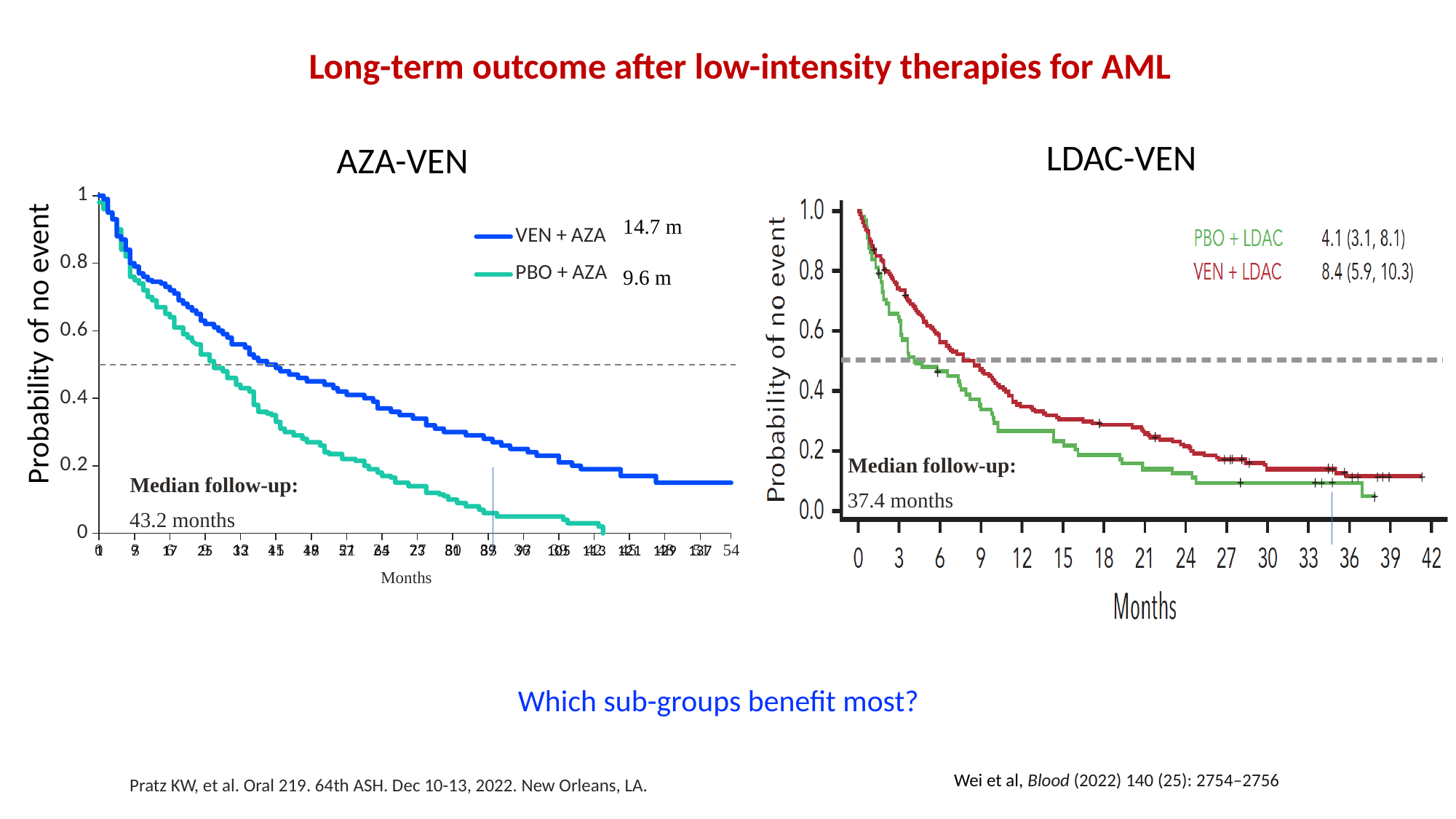
On the AZA-VEN chart, what is the median follow-up? 43.2 months What kind of chart is the LDAC-VEN chart? Line chart On the AZA-VEN chart, what median value is shown for VEN + AZA? 14.7 m On the LDAC-VEN chart, is the VEN + LDAC curve at 12 months greater or less than 0.2? greater On the AZA-VEN chart, which arm has the larger median, VEN + AZA or PBO + AZA? VEN + AZA On the AZA-VEN chart, what is the difference between the VEN + AZA and PBO + AZA medians? 5.1 m On the LDAC-VEN chart, what value is shown for PBO + LDAC? 4.1 (3.1, 8.1) On the LDAC-VEN chart, how many series does the legend list? 2 On the LDAC-VEN chart, what value is shown for VEN + LDAC? 8.4 (5.9, 10.3) On the AZA-VEN chart, what median value is shown for PBO + AZA? 9.6 m On the LDAC-VEN chart, what is the median follow-up? 37.4 months On the AZA-VEN chart, do the curves rise or fall as months increase? Fall